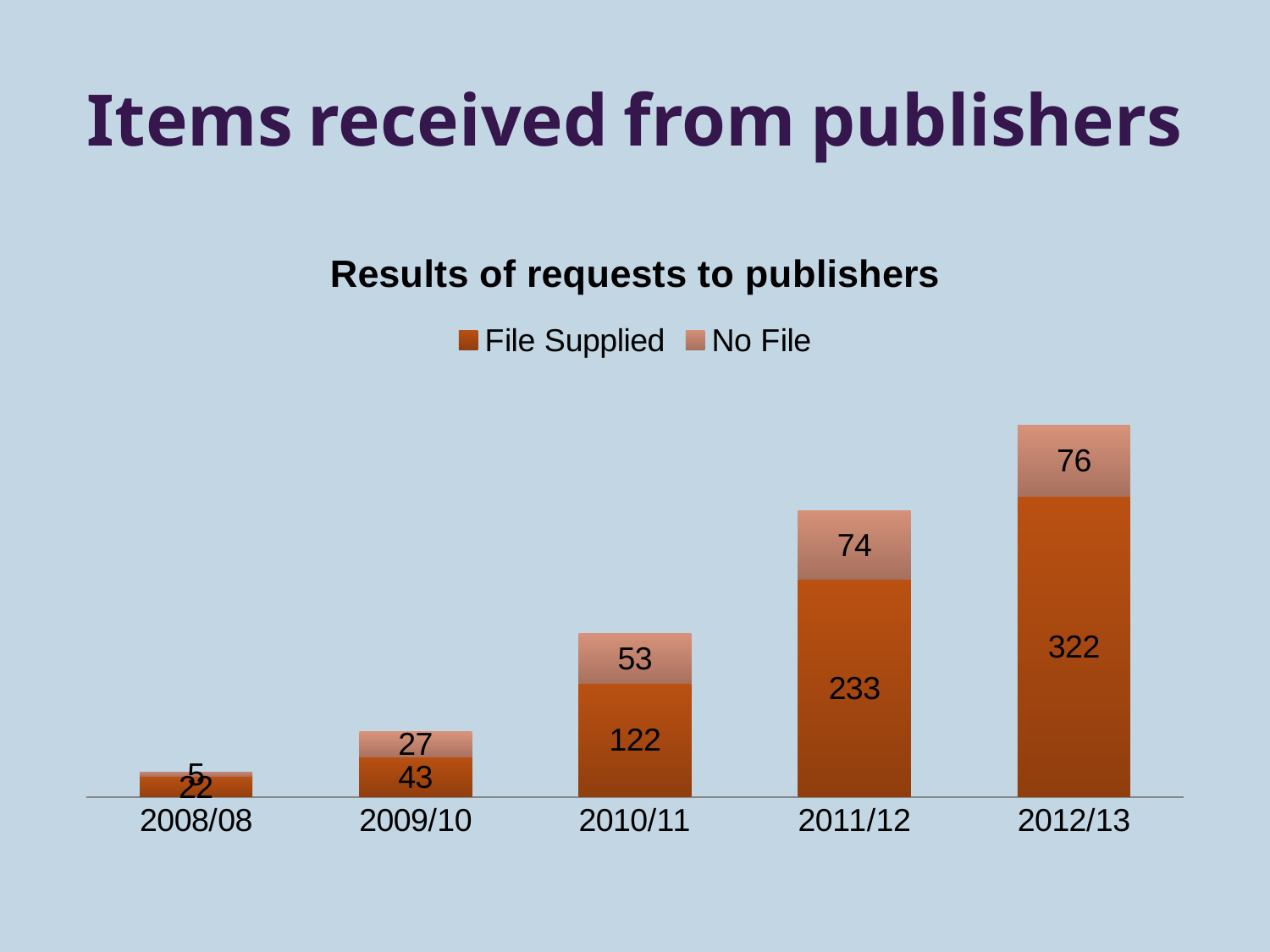
What is the File Supplied value for 2010/11? 122 How many categories are shown on the x axis? 5 What type of chart is shown on the slide? Stacked bar chart Does the File Supplied value rise or fall from 2009/10 to 2012/13? Rise Which year has the lowest No File value? 2008/08 Which year has the highest File Supplied value? 2012/13 What is the difference between the File Supplied values for 2012/13 and 2011/12? 89 What is the total of the stacked bar for 2010/11? 175 How many series does the legend list? 2 What is the No File value for 2011/12? 74 What is the File Supplied value for 2012/13? 322 What is the title of the chart? Results of requests to publishers